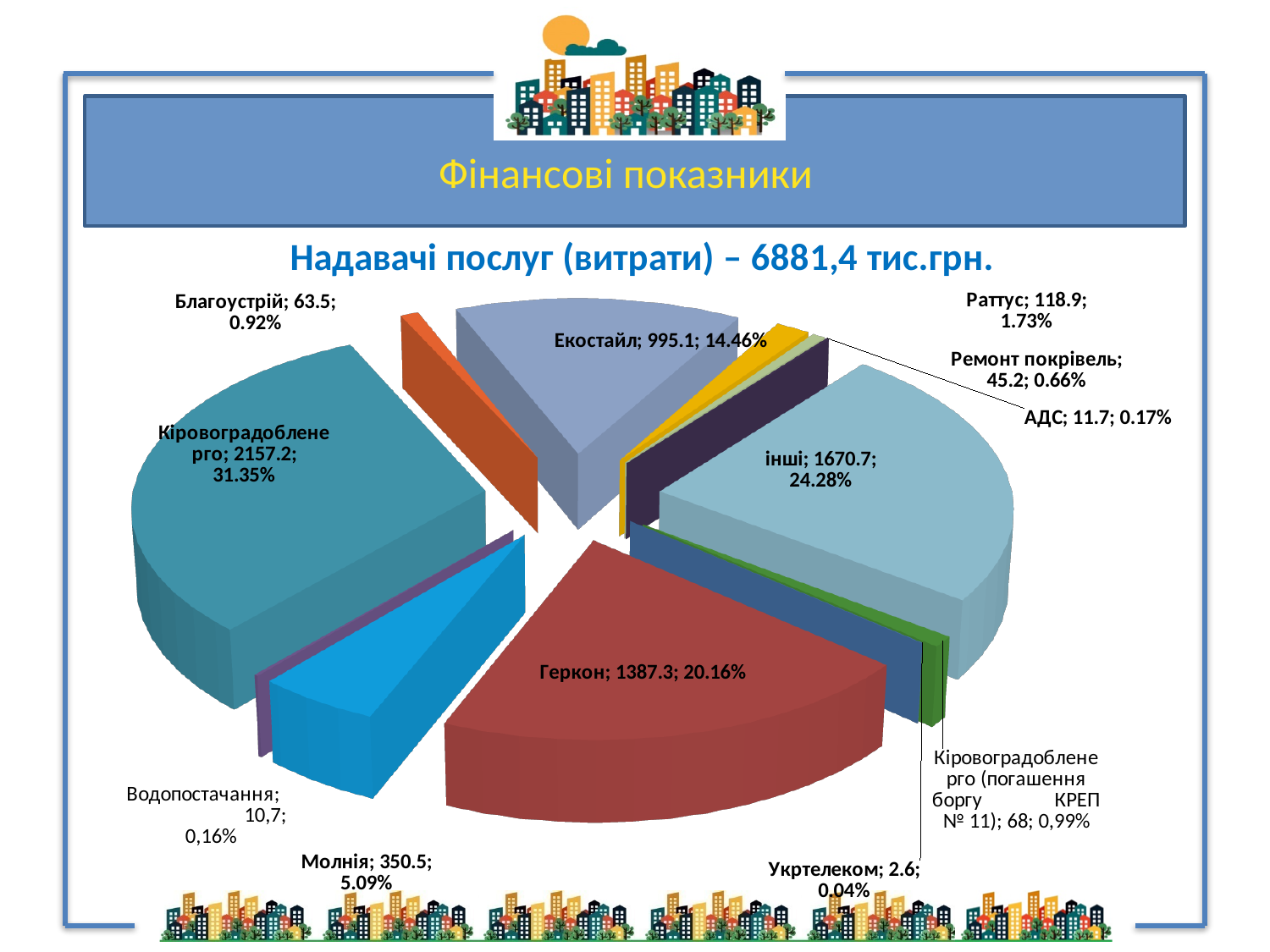
What is the difference between the values for Кіровоградобленерго and Геркон? 769.9 What share of the pie does Молнія represent? 5.09% Which category has the smallest slice of the pie? Укртелеком Which is larger, the value for Раттус or the value for Благоустрій? Раттус What kind of chart is shown on the slide? pie chart What share of the pie does Геркон represent? 20.16% Which category has the largest slice of the pie? Кіровоградобленерго What is the value for інші? 1670.7 What is the value for Екостайл? 995.1 What is the title of the chart? Надавачі послуг (витрати) – 6881,4 тис.грн. What is the value for Ремонт покрівель? 45.2 How many categories are shown in the pie chart? 12